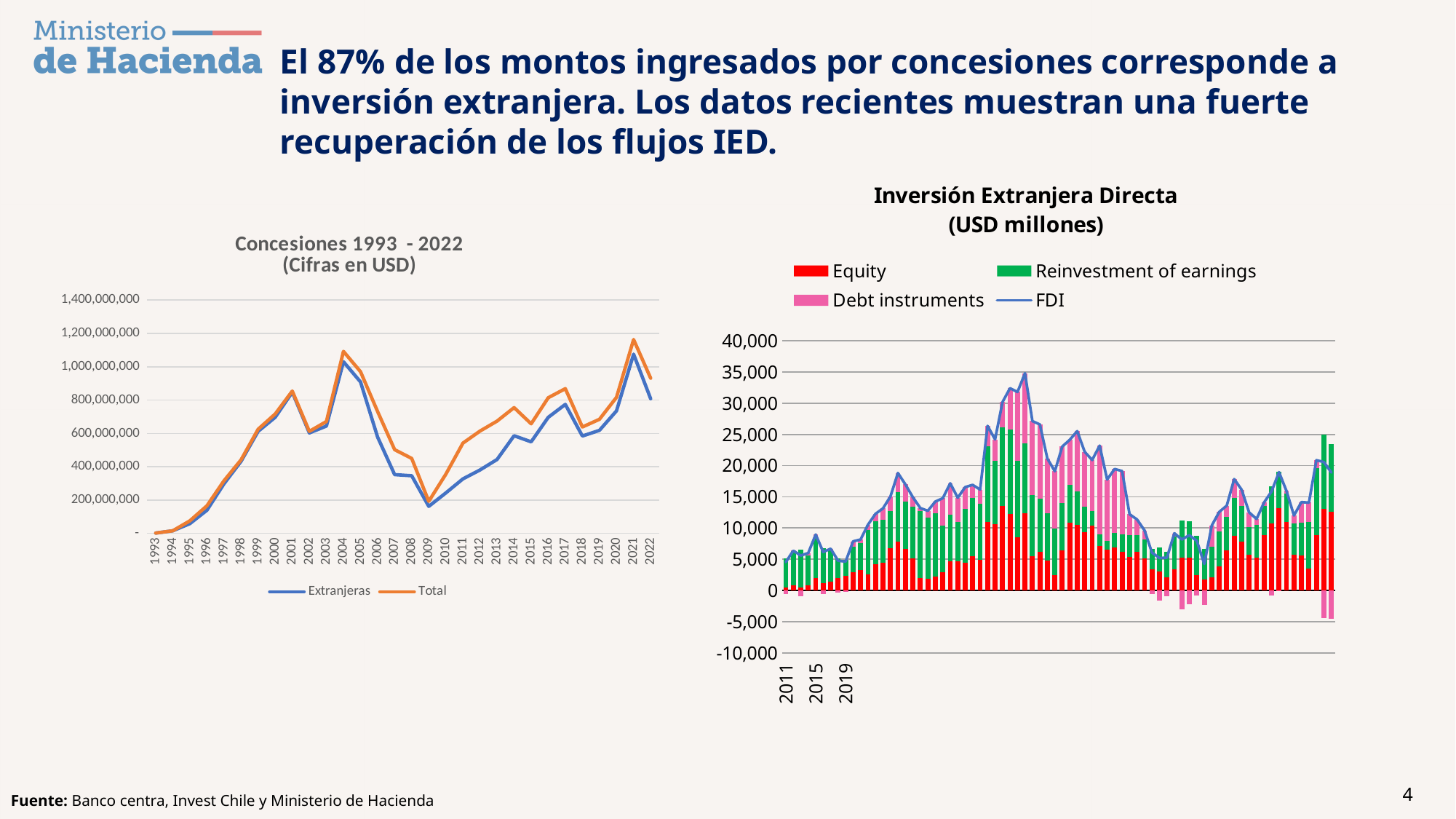
In the 'Inversión Extranjera Directa (USD millones)' chart, which colour represents Equity? Red In the 'Inversión Extranjera Directa (USD millones)' chart, is the peak value of the FDI line greater or less than 30,000? greater In the 'Concesiones 1993 - 2022' chart, which year has the lowest Total value? 1993 In the 'Concesiones 1993 - 2022' chart, is the Total value for 2021 greater or less than 1,000,000,000? greater How many series does the legend of the 'Concesiones 1993 - 2022' chart list? 2 How many years are shown on the x axis of the 'Concesiones 1993 - 2022' chart? 30 How many series does the legend of the 'Inversión Extranjera Directa (USD millones)' chart list? 4 What kind of chart is the 'Concesiones 1993 - 2022' chart on the left? Line chart In the 'Concesiones 1993 - 2022' chart, which year has the highest Total value? 2021 In the 'Concesiones 1993 - 2022' chart, do the Extranjeras values rise or fall from 2009 to 2013? Rise In the 'Concesiones 1993 - 2022' chart, is the Extranjeras value for 2009 greater or less than 400,000,000? less In the 'Concesiones 1993 - 2022' chart, which series is larger in 2017, Extranjeras or Total? Total